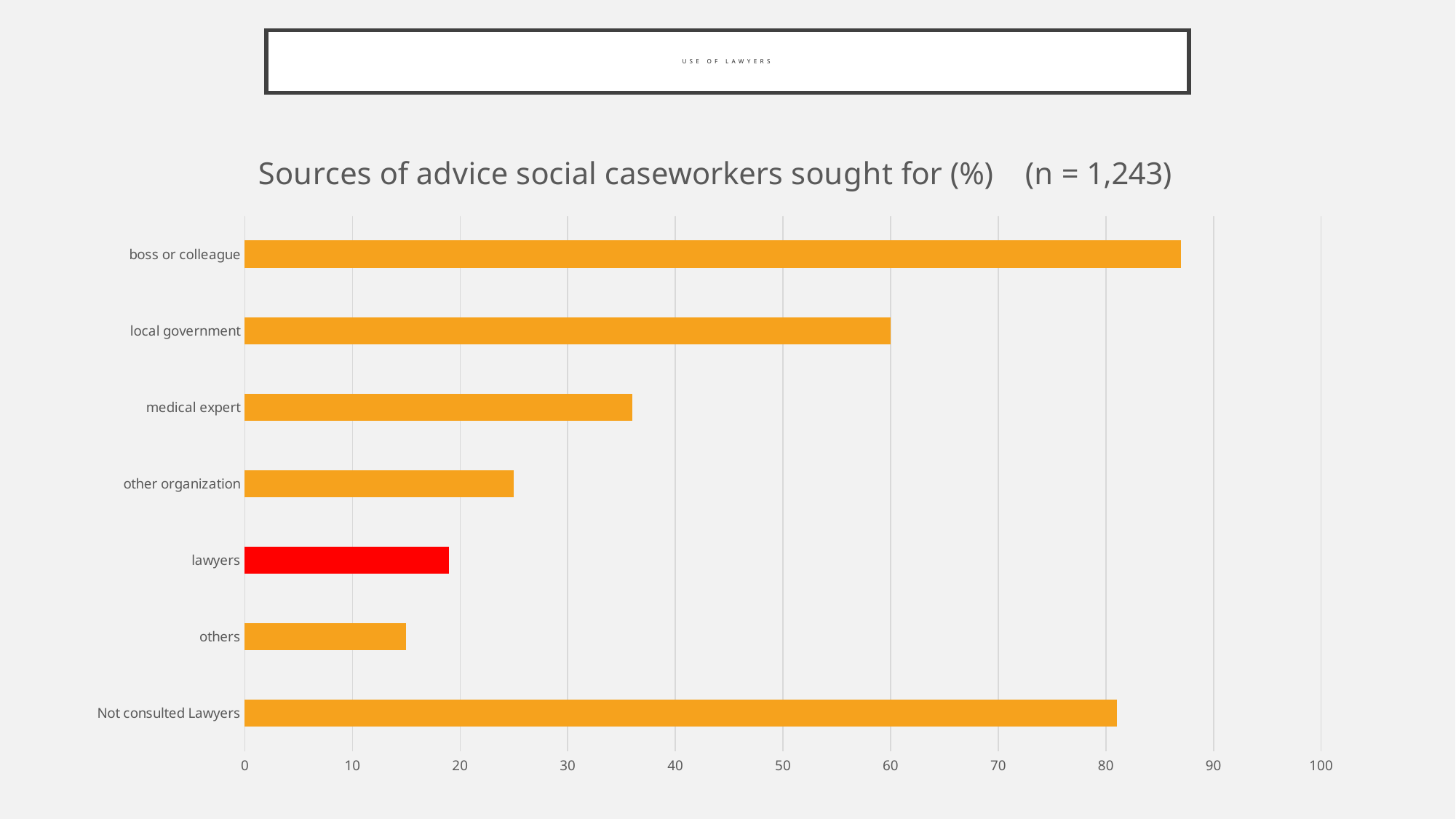
Which category has the lowest value? others Is the value for boss or colleague greater or less than 80? greater What kind of chart is shown on the slide? bar chart What sample size (n) is given in the chart title? 1,243 Which bar is coloured red rather than orange? lawyers Is the value for medical expert greater or less than 40? less Which is larger, the value for local government or the value for medical expert? local government Is the value for Not consulted Lawyers greater or less than 70? greater How many categories are plotted in the chart? 7 Which category has the highest value? boss or colleague What is the value for local government? 60